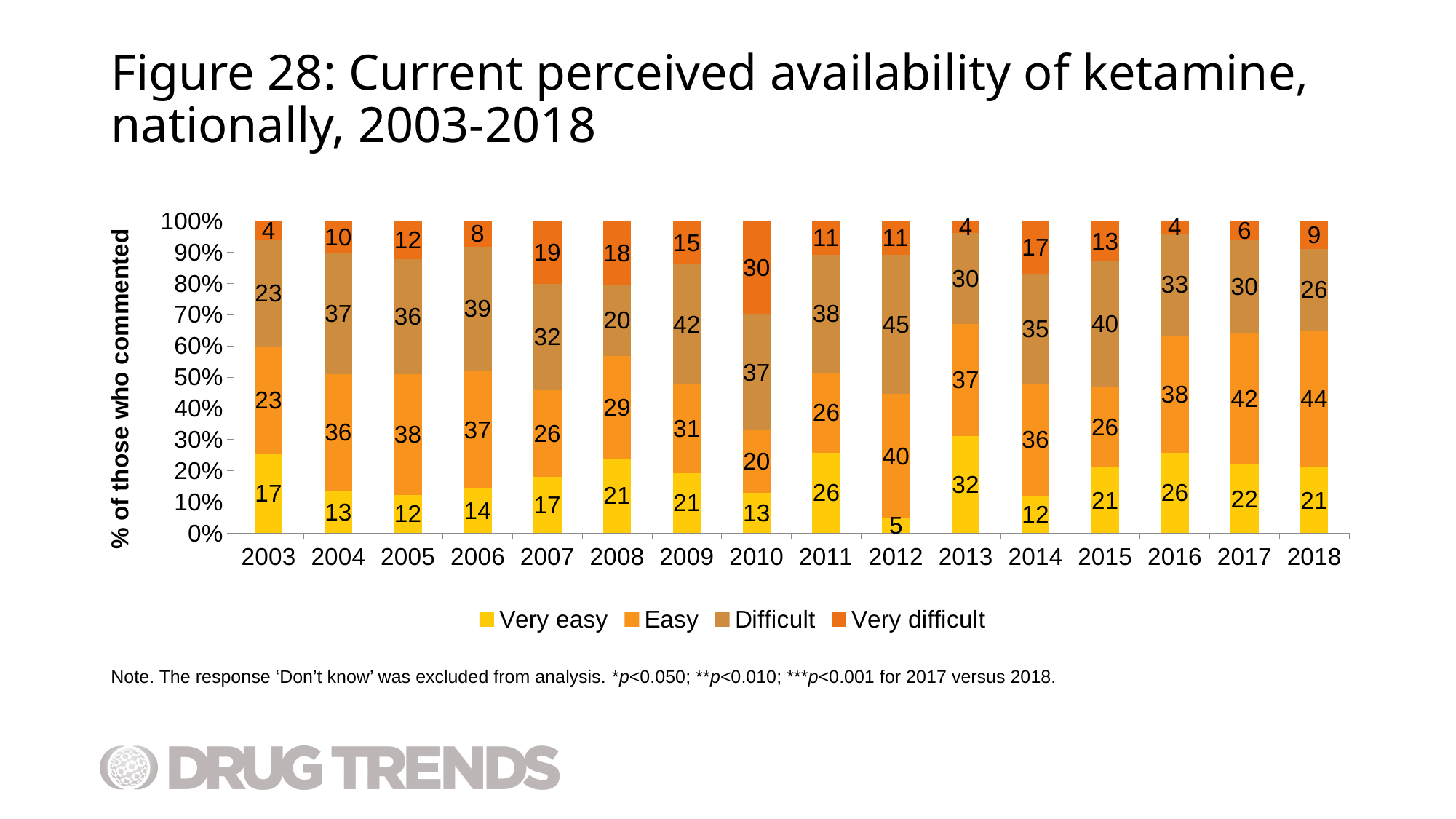
What is the label of the y axis? % of those who commented In which year is the 'Very easy' segment the largest? 2013 How many series does the legend list? 4 What is the difference between the 'Easy' values for 2018 and 2017? 2 In which year is the 'Difficult' segment the largest? 2012 In which year is the 'Very easy' segment the smallest? 2012 Which is larger, the 'Very difficult' value for 2007 or for 2008? 2007 What is the 'Very difficult' value for 2010? 30 What percentage of respondents rated ketamine as 'Very easy' to obtain in 2013? 32 What is the 'Easy' value for 2018? 44 What kind of chart is shown on the slide? Stacked bar chart How many years are shown on the x axis? 16